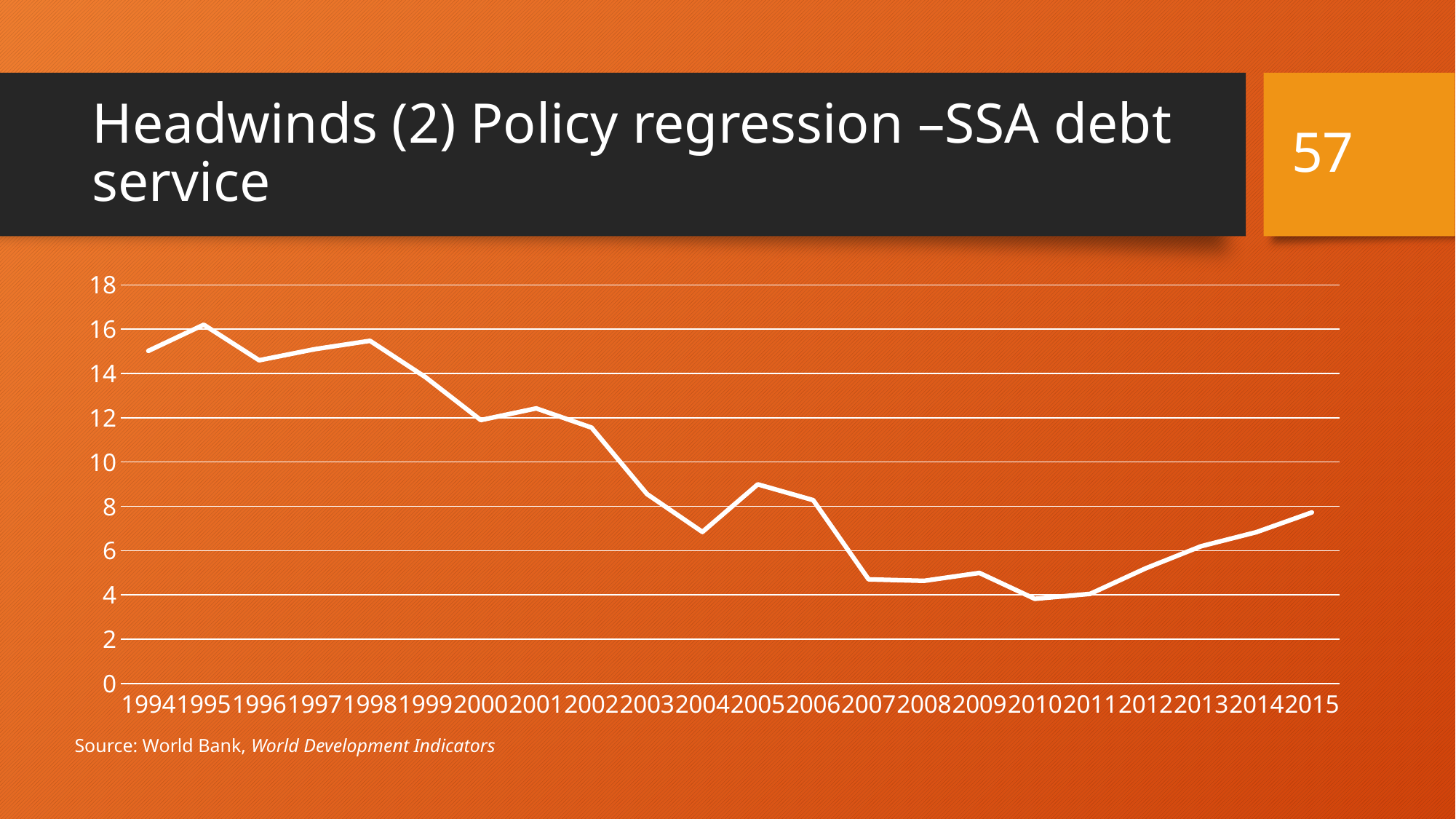
What kind of chart is shown on the slide? line chart Is the value for 2014 greater or less than 6? greater Is the value for 2005 greater or less than 8? greater What source is cited below the chart? World Bank, World Development Indicators Does the line generally rise or fall between 1994 and 2010? fall Which is larger, the value for 1994 or the value for 2015? 1994 Which year has the highest value on the chart? 1995 Is the value for 1994 greater or less than 14? greater How many years are plotted along the x axis of the chart? 22